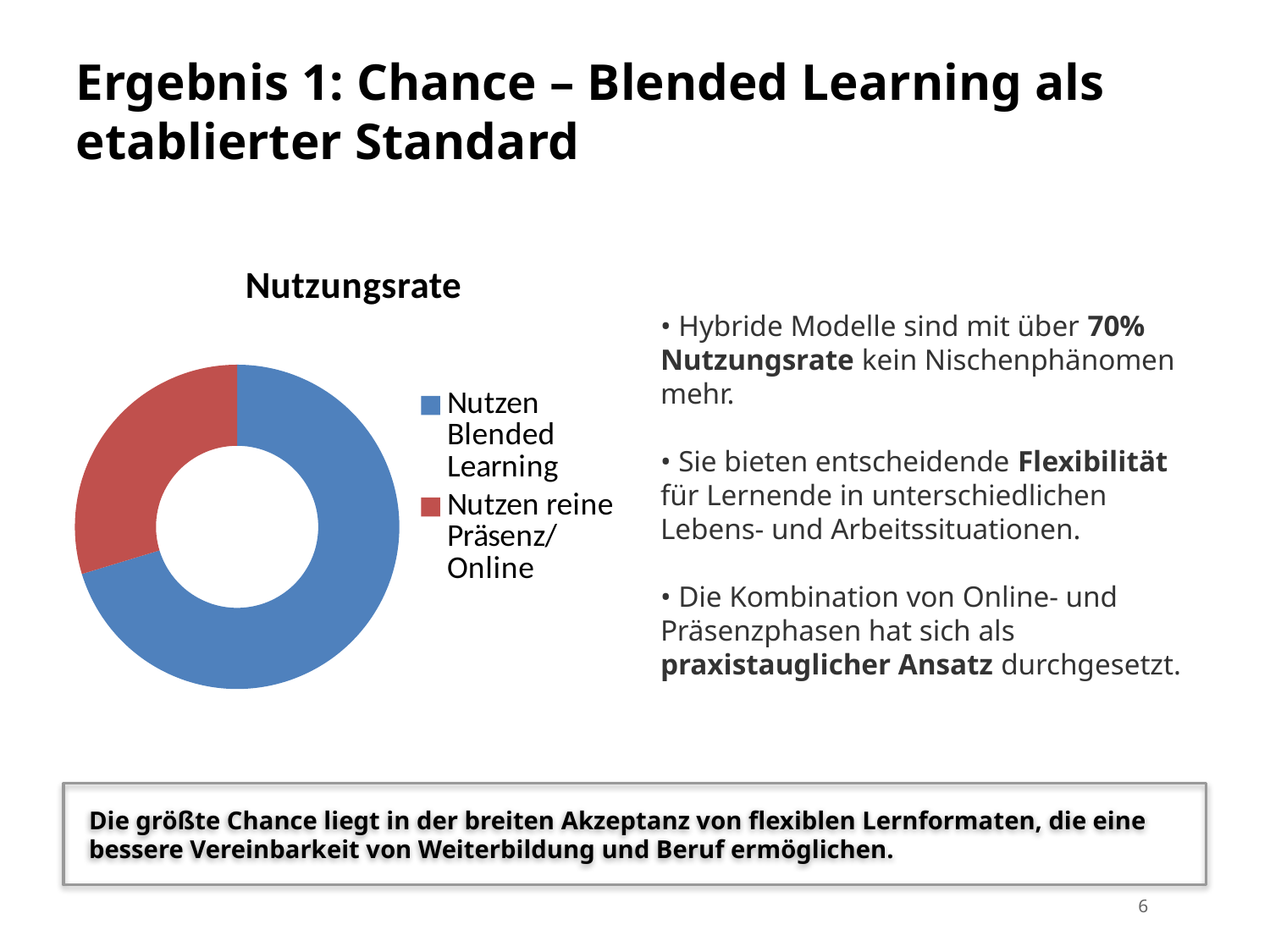
Which category has the smallest share in the Nutzungsrate chart? Nutzen reine Präsenz/Online In the Nutzungsrate chart, which is larger: Nutzen Blended Learning or Nutzen reine Präsenz/Online? Nutzen Blended Learning What kind of chart is shown on the slide? Doughnut chart How many categories does the Nutzungsrate chart show? 2 Which category has the largest share in the Nutzungsrate chart? Nutzen Blended Learning How many entries does the legend of the Nutzungsrate chart list? 2 What is the title of the chart on the slide? Nutzungsrate What colour represents Nutzen reine Präsenz/Online in the Nutzungsrate chart? Red